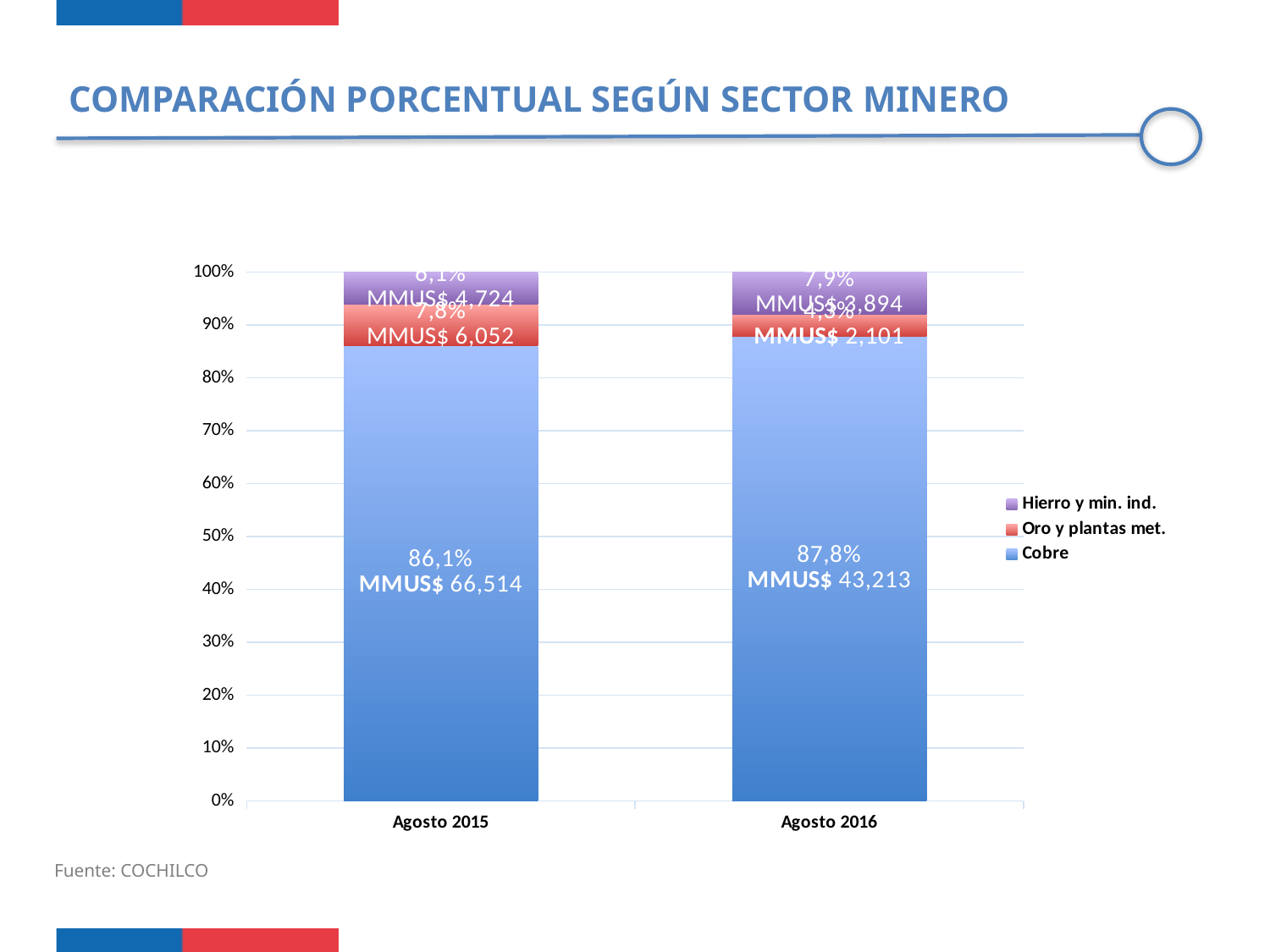
What is the source cited below the chart? COCHILCO What is the MMUS$ value labelled for Oro y plantas met. in Agosto 2016? MMUS$ 2,101 What percentage share does Hierro y min. ind. have in Agosto 2016? 7,9% How many series does the legend list? 3 What percentage share does Cobre have in Agosto 2016? 87,8% What is the MMUS$ value labelled for Cobre in Agosto 2016? MMUS$ 43,213 What kind of chart is shown on the slide? Stacked bar chart What percentage share does Cobre have in Agosto 2015? 86,1% In which period is the percentage share of Cobre larger, Agosto 2015 or Agosto 2016? Agosto 2016 What percentage share does Oro y plantas met. have in Agosto 2015? 7,8% How many categories are shown on the x axis? 2 What is the MMUS$ value labelled for Cobre in Agosto 2015? MMUS$ 66,514